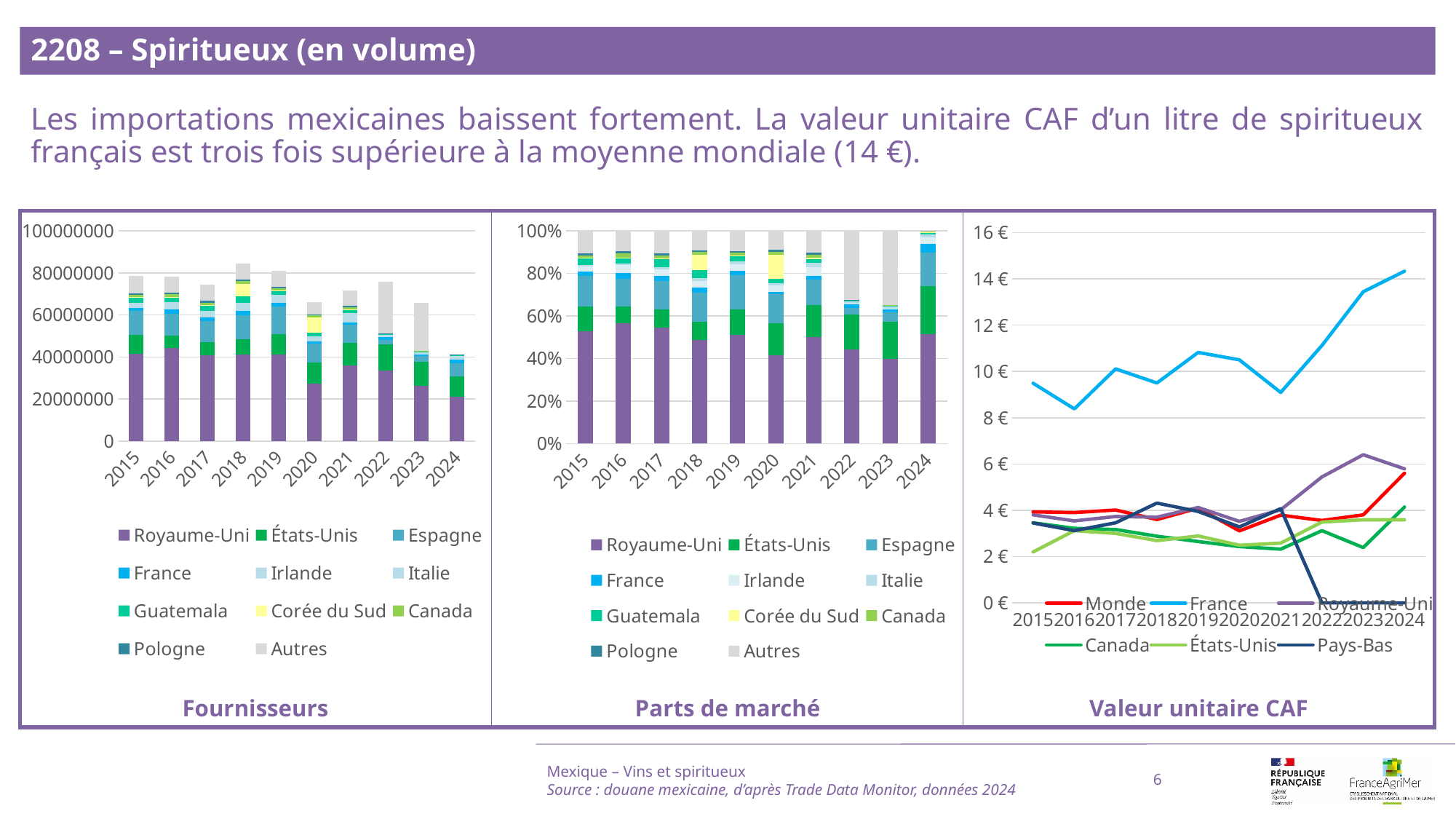
How many series does the legend of the 'Parts de marché' chart list? 11 In the 'Fournisseurs' chart, is the total height of the 2024 bar greater or less than 60000000? less In the 'Valeur unitaire CAF' chart, is the value for France in 2024 greater or less than 12 €? greater In the 'Valeur unitaire CAF' chart, does the France line generally rise or fall from 2015 to 2024? rise In the 'Valeur unitaire CAF' chart, which series has the highest value in 2024? France How many years are shown on the x axis of the 'Fournisseurs' chart? 10 How many series does the legend of the 'Valeur unitaire CAF' chart list? 6 What kind of chart is the 'Valeur unitaire CAF' chart? line chart What kind of chart is the 'Fournisseurs' chart? stacked bar chart In the 'Fournisseurs' chart, do the total bar heights generally rise or fall from 2015 to 2024? fall In the 'Valeur unitaire CAF' chart, is the value for Pays-Bas in 2024 greater or less than 2 €? less In the 'Valeur unitaire CAF' chart, which series has the lowest value in 2024? Pays-Bas